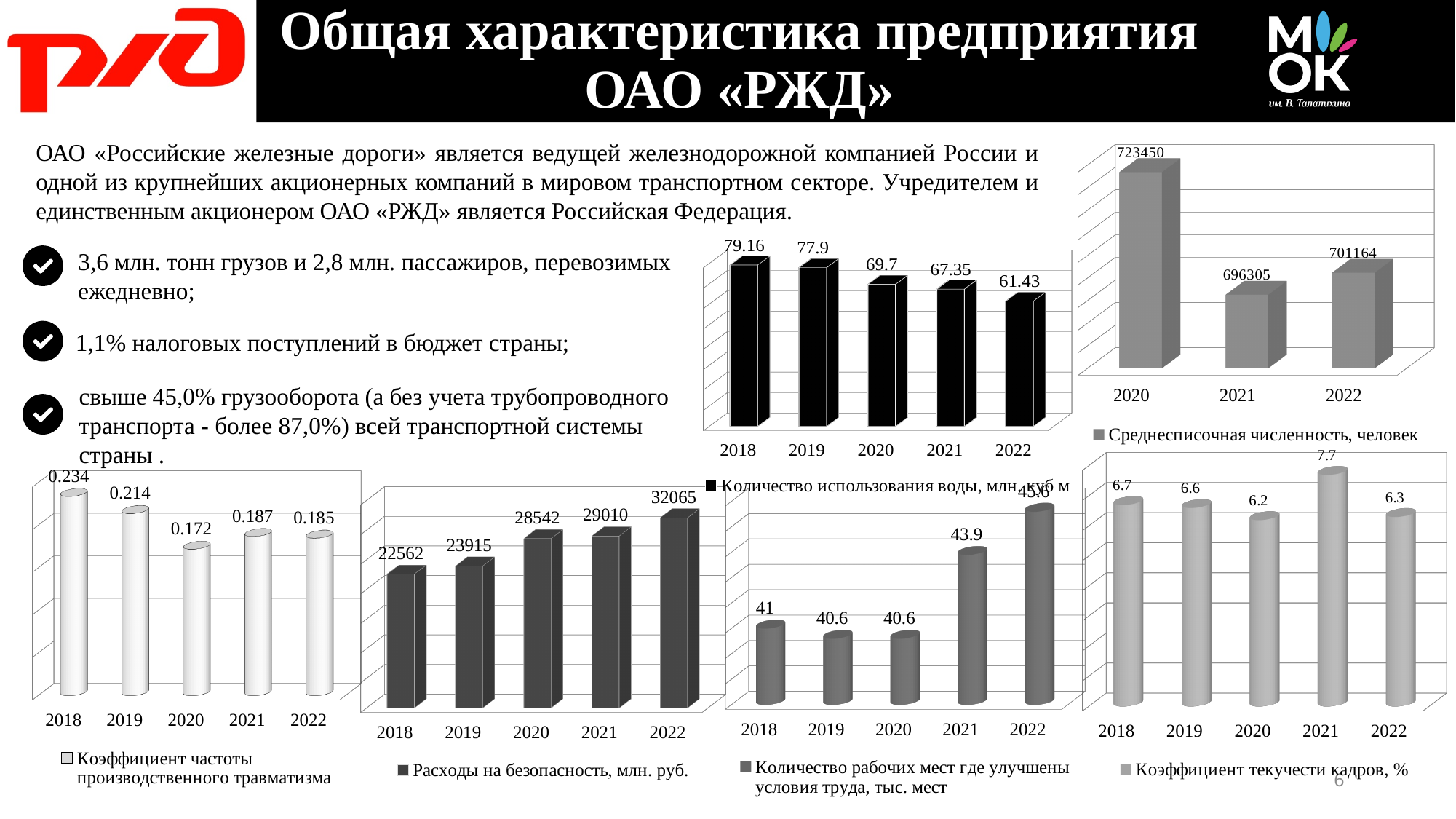
In the chart 'Коэффициент текучести кадров, %', which is larger, the value for 2018 or the value for 2020? 2018 In the chart 'Среднесписочная численность, человек', which year has the lowest value? 2021 In the chart 'Коэффициент частоты производственного травматизма', which year has the highest value? 2018 In the chart 'Расходы на безопасность, млн. руб.', what is the value for 2022? 32065 In the chart 'Коэффициент частоты производственного травматизма', what is the value for 2020? 0.172 In the chart 'Коэффициент текучести кадров, %', which year has the highest value? 2021 In the chart 'Среднесписочная численность, человек', what is the difference between the 2020 and 2022 values? 22286 In the chart 'Расходы на безопасность, млн. руб.', what is the difference between the 2022 and 2018 values? 9503 In the chart 'Количество рабочих мест где улучшены условия труда, тыс. мест', what is the value for 2021? 43.9 In the chart 'Количество использования воды, млн. куб м', what is the value for 2018? 79.16 How many years are shown in the chart 'Среднесписочная численность, человек'? 3 In the chart 'Количество использования воды, млн. куб м', do the values rise or fall from 2018 to 2022? fall